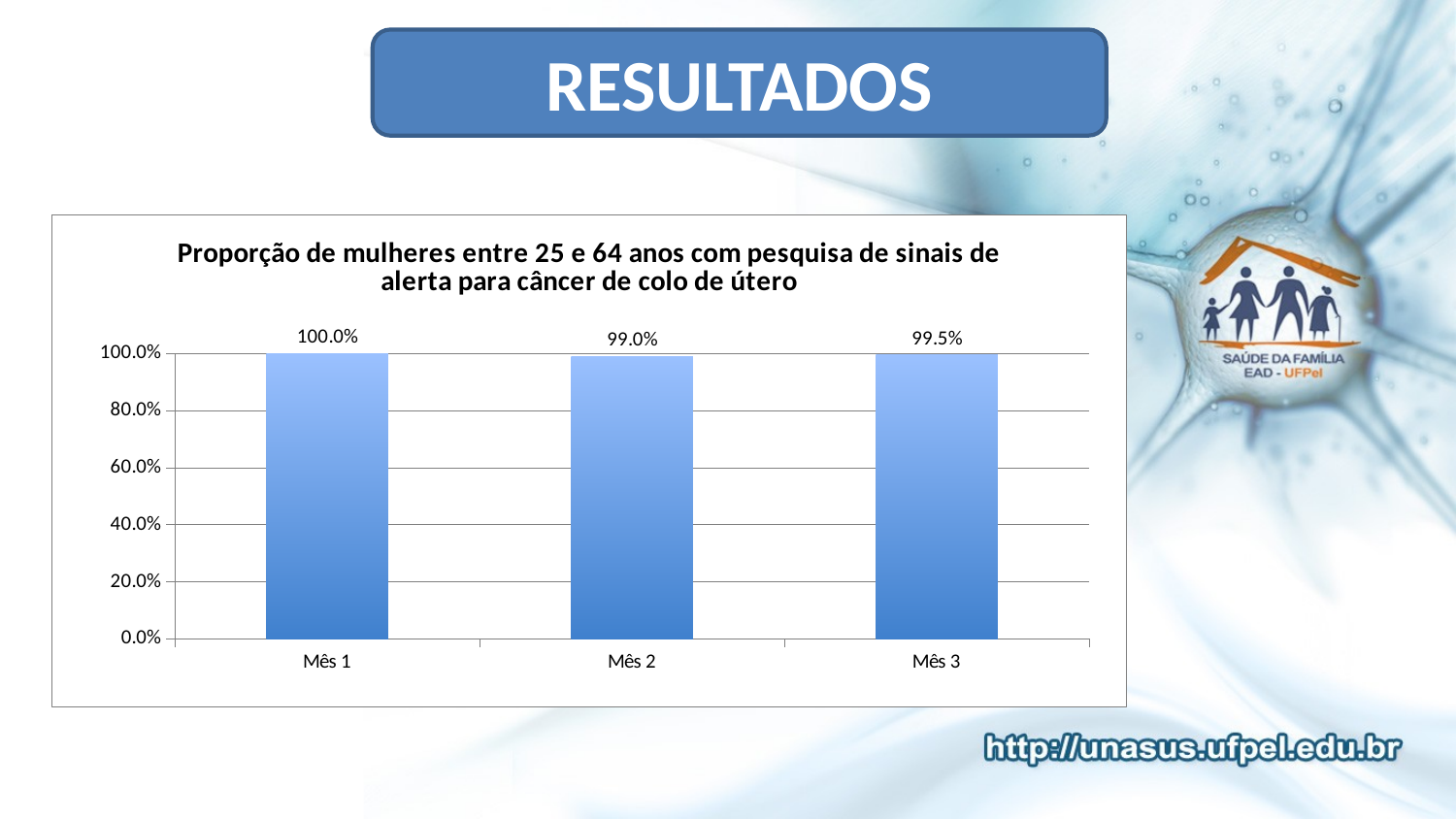
What is the value for Mês 2? 99.0% Which is larger, the value for Mês 2 or the value for Mês 3? Mês 3 What kind of chart is shown on the slide? Bar chart Which month has the lowest value? Mês 2 What is the difference between the values for Mês 1 and Mês 2? 1.0% What is the difference between the values for Mês 3 and Mês 2? 0.5% Is the value for Mês 2 greater or less than 80.0%? greater What is the title of the chart? Proporção de mulheres entre 25 e 64 anos com pesquisa de sinais de alerta para câncer de colo de útero How many months are shown on the x axis? 3 Which month has the highest value? Mês 1 What is the value for Mês 3? 99.5% What is the value for Mês 1? 100.0%